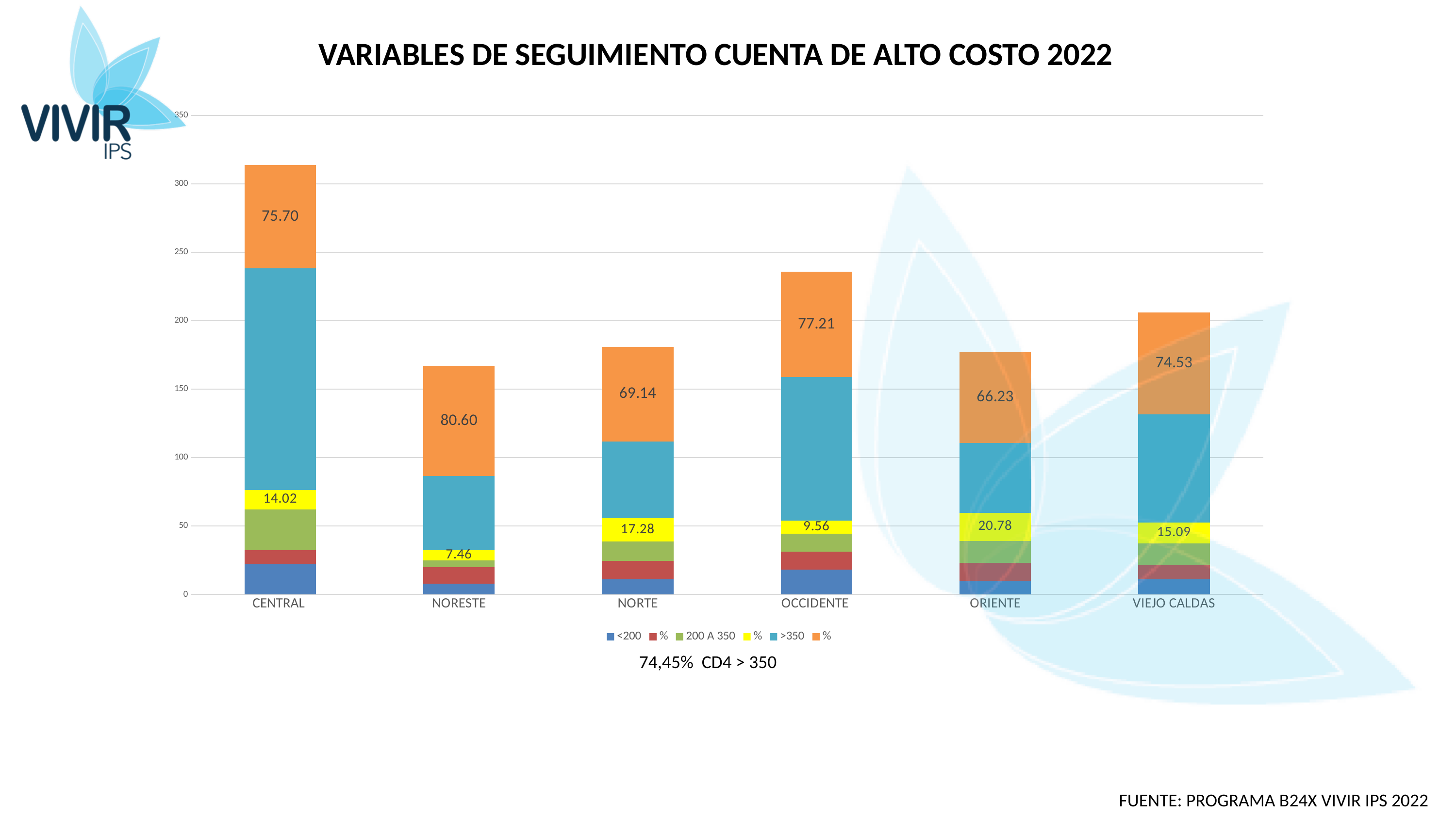
Which region has the lowest value printed on its yellow segment? NORESTE What kind of chart is shown on the slide? stacked bar chart What is the difference between the orange-segment values of CENTRAL (75.70) and VIEJO CALDAS (74.53)? 1.17 What value is printed on the yellow segment of the ORIENTE bar? 20.78 Is the total height of the CENTRAL stacked bar greater or less than 300? greater Which region has the lowest value printed on its orange segment? ORIENTE Which has the larger yellow-segment value, NORTE or VIEJO CALDAS? NORTE What value is printed on the orange segment of the NORESTE bar? 80.60 How many series does the legend list? 6 What is the title of the chart? VARIABLES DE SEGUIMIENTO CUENTA DE ALTO COSTO 2022 How many regions (categories) are shown along the x axis? 6 Which region has the highest value printed on its orange segment? NORESTE